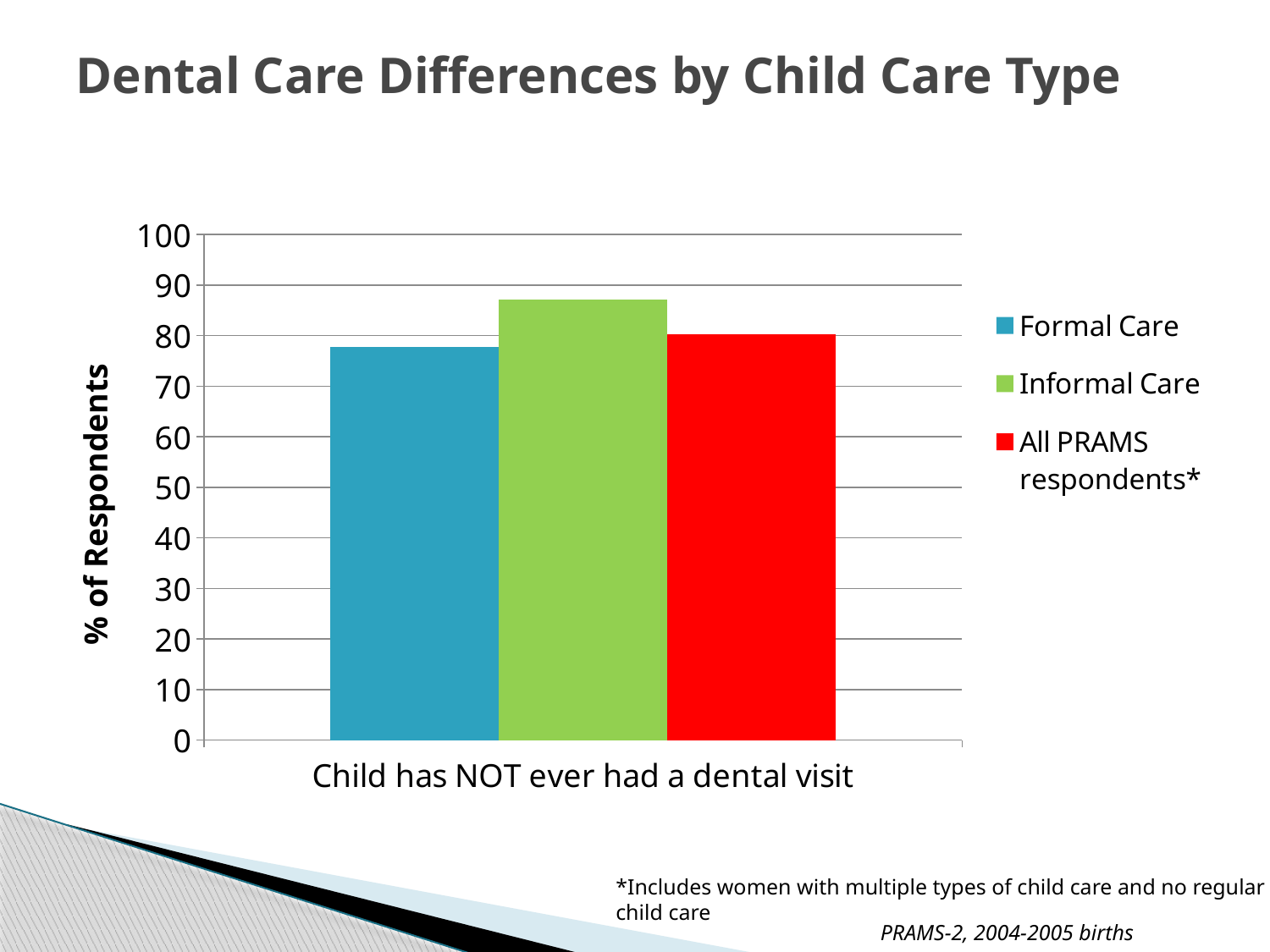
Is the value for Informal Care greater or less than 90? less Which series has the highest value for "Child has NOT ever had a dental visit"? Informal Care How many series does the legend list? 3 What kind of chart is shown on the slide? bar chart Is the value for Formal Care greater or less than 70? greater Which is larger, the value for Informal Care or the value for All PRAMS respondents*? Informal Care Is the value for All PRAMS respondents* greater or less than 70? greater Which is larger, the value for Informal Care or the value for Formal Care? Informal Care What colour is the bar for Informal Care? green What is the label on the y axis? % of Respondents How many categories are shown on the x axis? 1